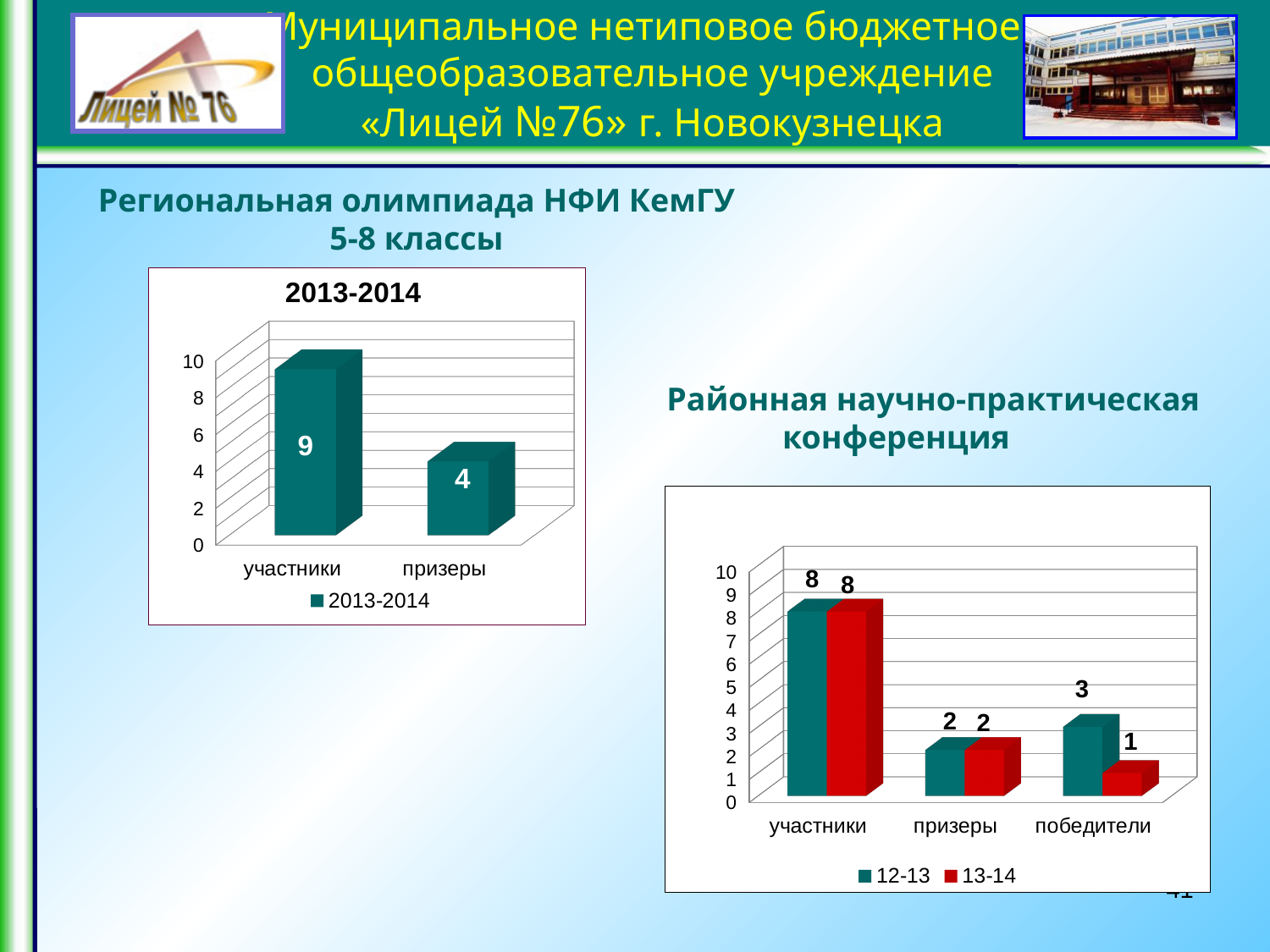
In the right chart (Районная научно-практическая конференция), what is the value for победители in the 12-13 series? 3 In the right chart (Районная научно-практическая конференция), what colour are the bars for the 13-14 series? red In the left chart titled 2013-2014, what is the value for участники? 9 In the right chart (Районная научно-практическая конференция), what is the value for победители in the 13-14 series? 1 In the right chart (Районная научно-практическая конференция), what is the value for участники in the 13-14 series? 8 In the left chart titled 2013-2014, how many categories are shown on the x axis? 2 In the right chart (Районная научно-практическая конференция), which is larger for победители: 12-13 or 13-14? 12-13 What kind of chart is the left chart titled 2013-2014? bar chart In the left chart titled 2013-2014, what is the value for призеры? 4 In the right chart (Районная научно-практическая конференция), how many series does the legend list? 2 In the right chart (Районная научно-практическая конференция), which category has the highest value in the 12-13 series? участники In the left chart titled 2013-2014, what is the difference between участники and призеры? 5